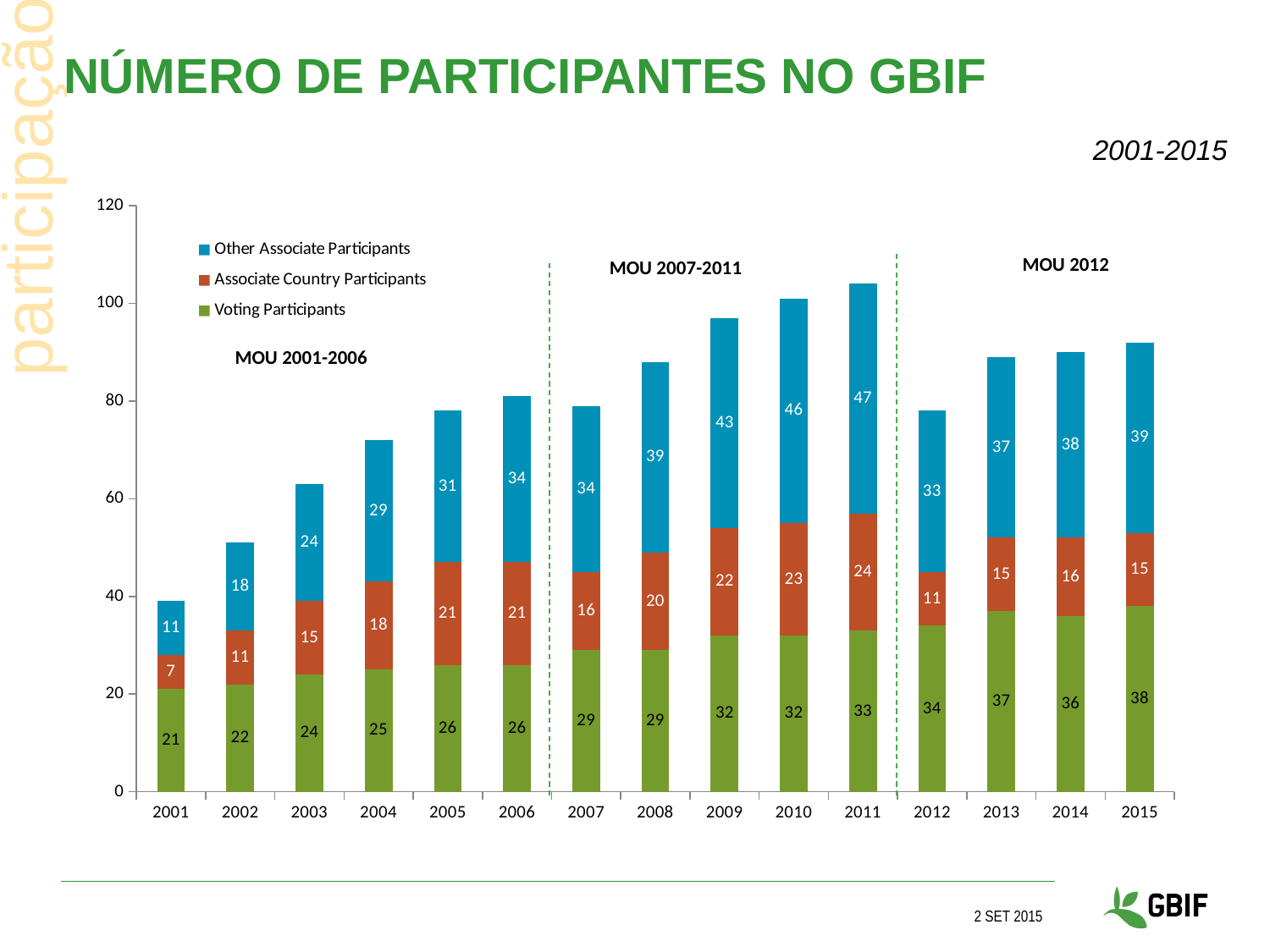
What kind of chart is shown on the slide? Stacked bar chart Which is larger: Other Associate Participants in 2009 or in 2013? 2009 Which year has the lowest value for Associate Country Participants? 2001 What is the difference between Voting Participants in 2015 and in 2001? 17 How many series does the legend list? 3 What is the value for Associate Country Participants in 2012? 11 What is the total of the stacked bar for 2011? 104 How many years are shown on the x axis? 15 Which year has the highest value for Other Associate Participants? 2011 What is the value for Voting Participants in 2001? 21 Is the total stacked value for 2010 greater or less than 100? greater What is the value for Other Associate Participants in 2011? 47